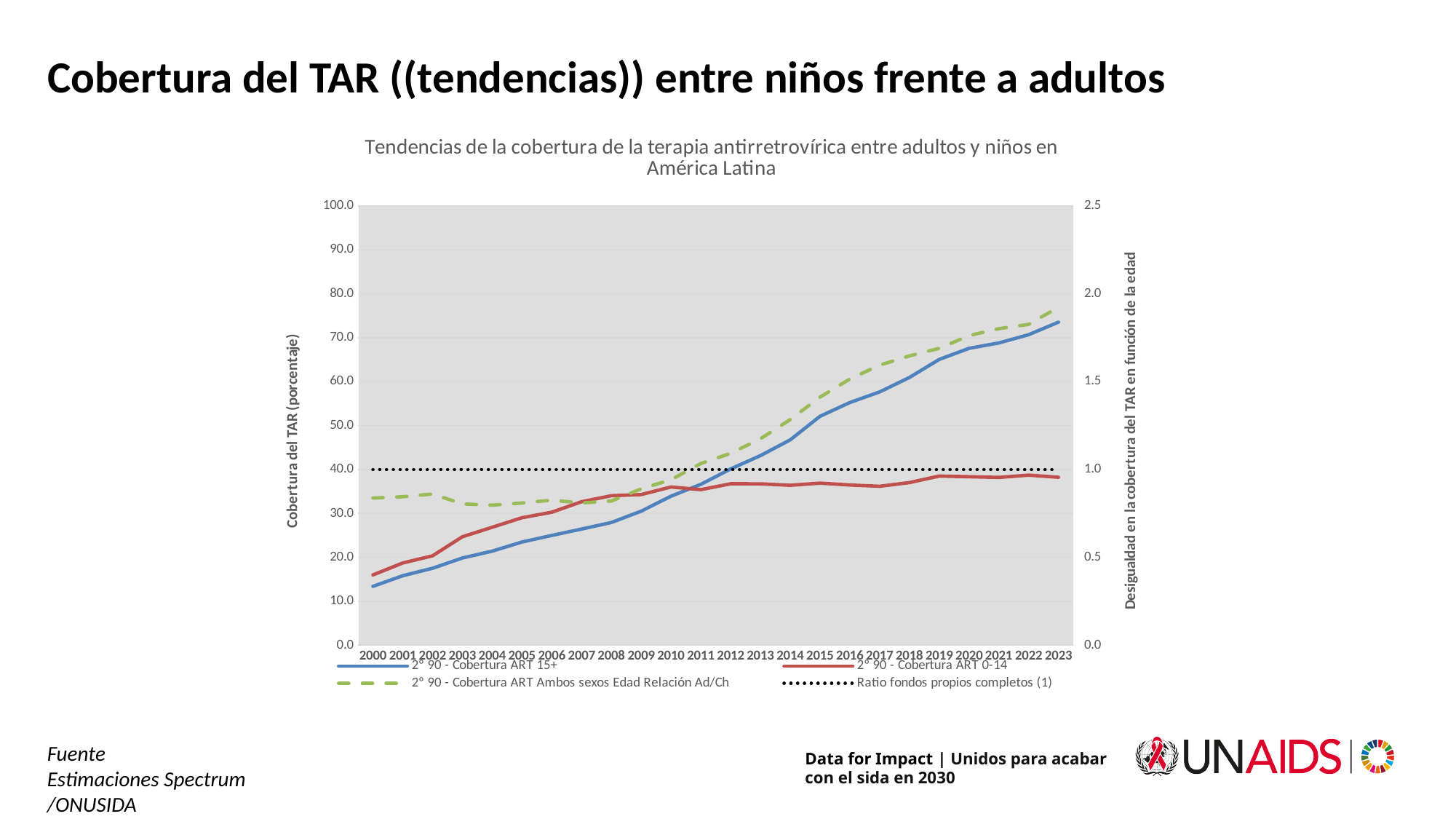
At what value on the right-hand axis does the dotted 'Ratio fondos propios completos (1)' line sit? 1.0 In 2023, which is larger: '2° 90 - Cobertura ART 15+' or '2° 90 - Cobertura ART 0-14'? 2° 90 - Cobertura ART 15+ Does the '2° 90 - Cobertura ART 15+' line rise or fall from 2000 to 2023? rise What is the last year shown on the x axis? 2023 Is the value for '2° 90 - Cobertura ART 15+' in 2000 greater or less than 20.0? less Is the value for '2° 90 - Cobertura ART 15+' in 2023 greater or less than 70.0? greater Is the value for '2° 90 - Cobertura ART 0-14' in 2023 greater or less than 40.0? less What is the first year shown on the x axis? 2000 How many series does the legend list? 4 What is the label of the left vertical axis? Cobertura del TAR (porcentaje) How many years are plotted along the x axis? 24 What kind of chart is shown on the slide? line chart